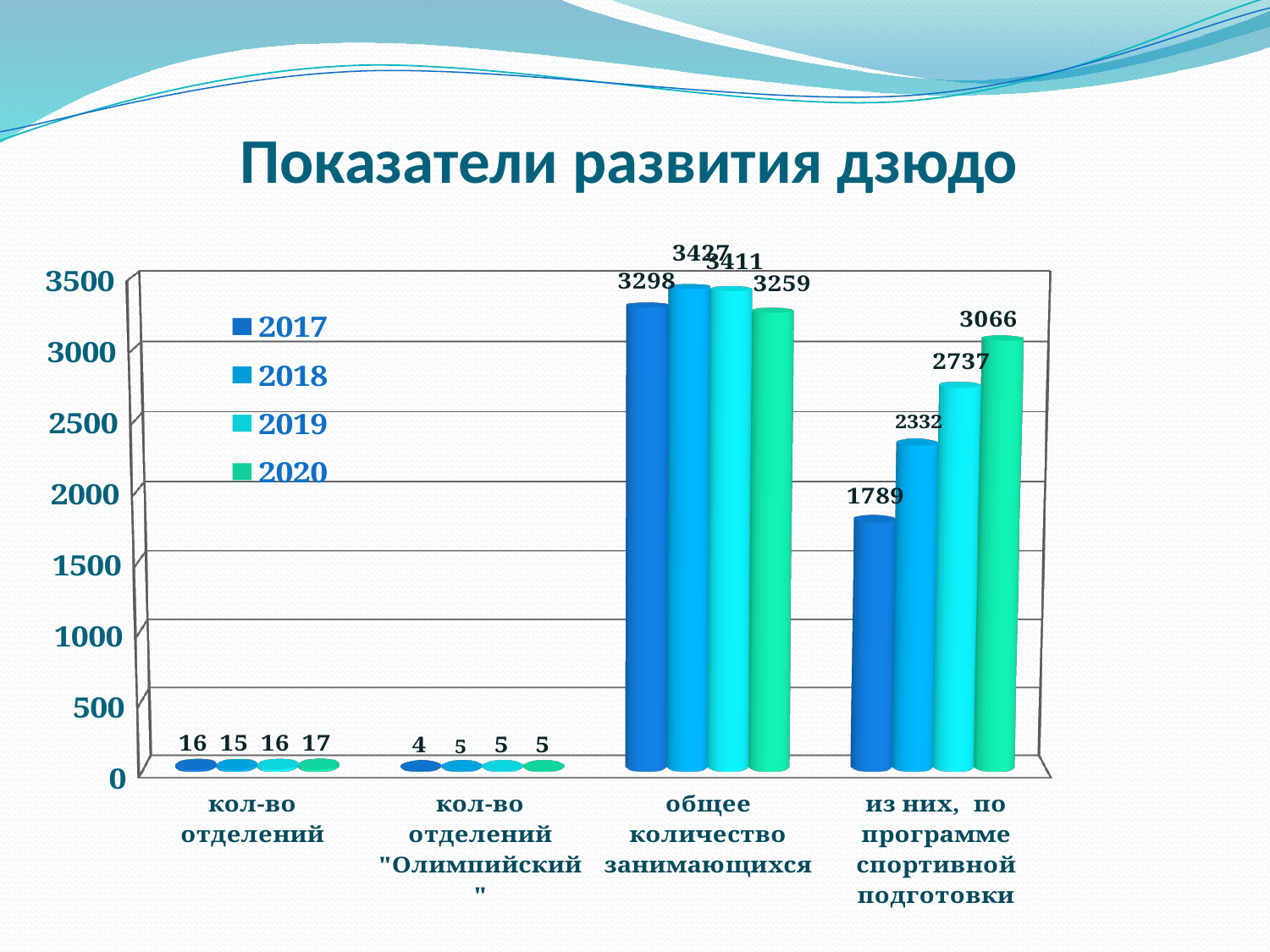
What is the difference between the 2020 and 2017 values in the category "из них, по программе спортивной подготовки"? 1277 Do the values in the category "из них, по программе спортивной подготовки" rise or fall from 2017 to 2020? Rise What kind of chart is shown on the slide? Bar chart Which year has the lowest value in the category "из них, по программе спортивной подготовки"? 2017 What is the value for 2017 in the category "кол-во отделений "Олимпийский""? 4 Which year has the highest value in the category "общее количество занимающихся"? 2018 How many categories are shown on the x axis? 4 How many series does the legend list? 4 What is the value for 2018 in the category "кол-во отделений"? 15 What is the value for 2020 in the category "из них, по программе спортивной подготовки"? 3066 Which is larger in the category "общее количество занимающихся": the value for 2019 or the value for 2020? 2019 What is the value for 2017 in the category "общее количество занимающихся"? 3298